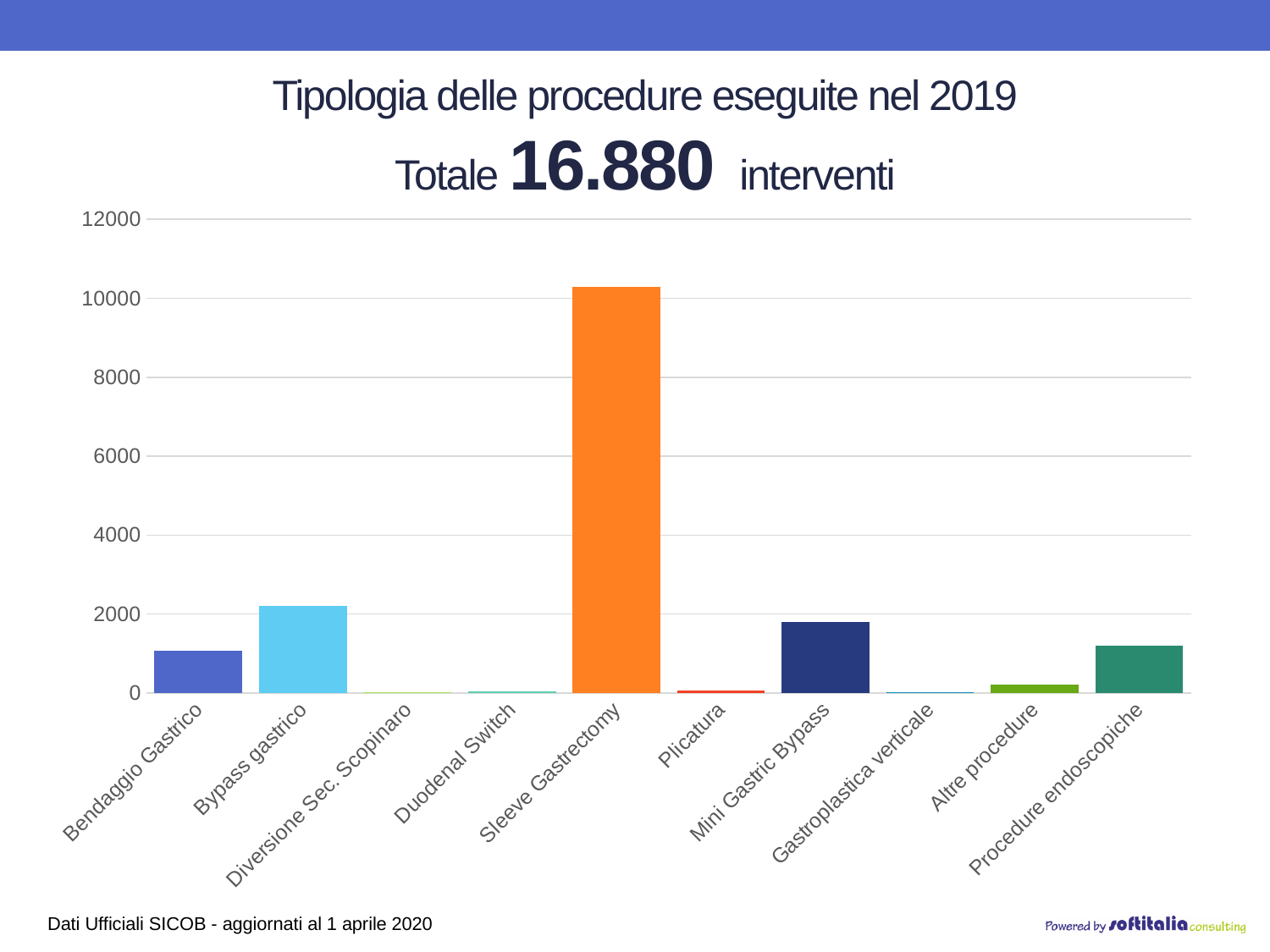
Is the value for Sleeve Gastrectomy greater or less than 10000? greater What total number of interventions is stated in the chart title? 16.880 Is the value for Mini Gastric Bypass greater or less than 2000? less What kind of chart is shown on the slide? bar chart Which is larger, the value for Bypass gastrico or the value for Mini Gastric Bypass? Bypass gastrico Which procedure has the highest bar? Sleeve Gastrectomy Is the value for Bendaggio Gastrico greater or less than 2000? less Which is larger, the value for Sleeve Gastrectomy or the value for Bypass gastrico? Sleeve Gastrectomy How many procedure categories are shown on the x axis? 10 What is the title of the chart? Tipologia delle procedure eseguite nel 2019